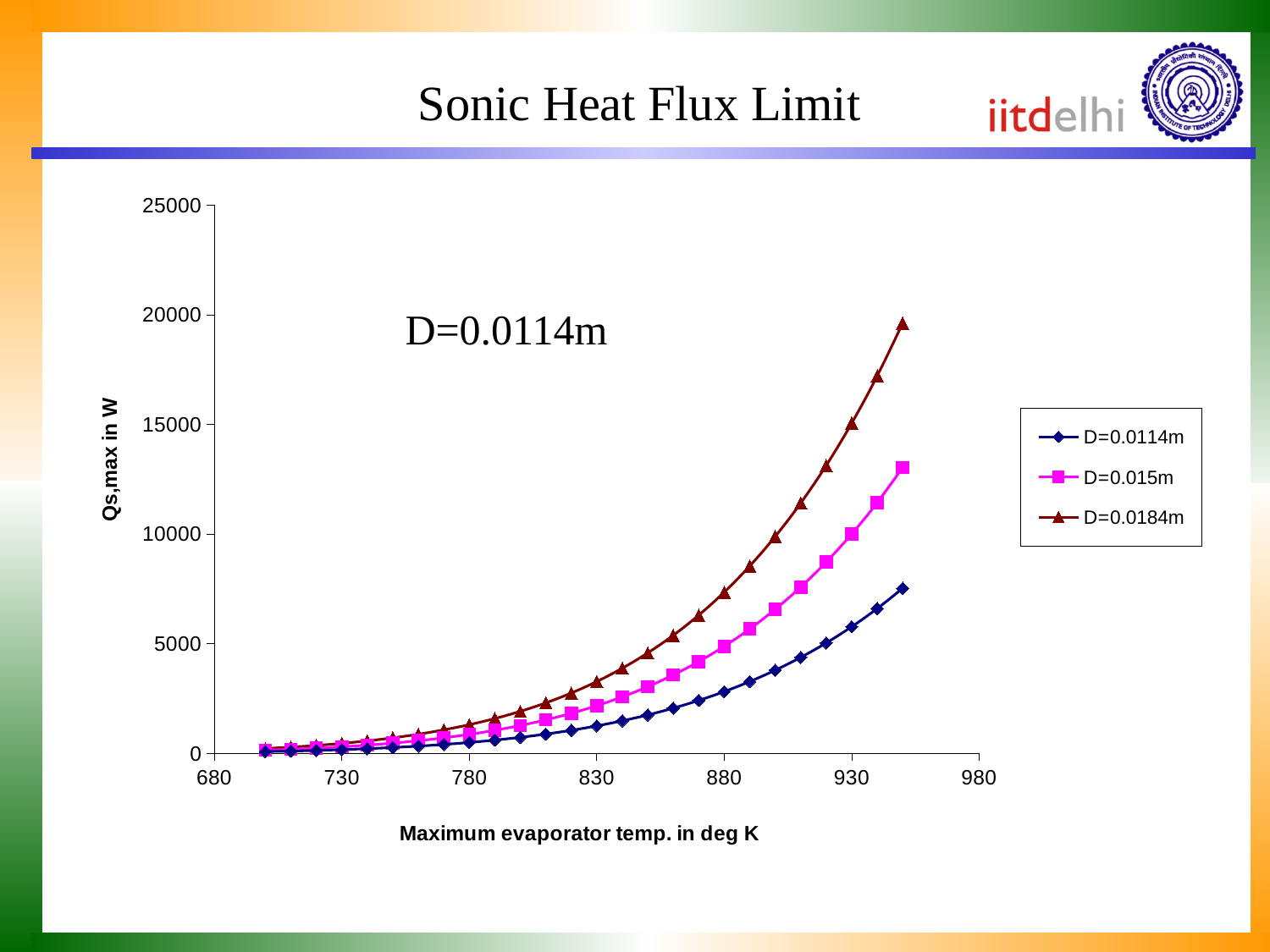
At 930 deg K, which series has the larger value, D=0.015m or D=0.0114m? D=0.015m What kind of chart is shown on the slide? line chart Is the value for D=0.0114m at 950 deg K greater or less than 10000? less What is the title of the y axis? Qs,max in W Do the values for D=0.015m rise or fall as the maximum evaporator temperature increases? rise Is the value for D=0.0114m at 950 deg K greater or less than 5000? greater Which series has the lowest values across the chart? D=0.0114m Is the value for D=0.0184m at 950 deg K greater or less than 15000? greater How many series does the legend list? 3 Which series reaches the highest value at the right end of the chart? D=0.0184m What is the title of the x axis? Maximum evaporator temp. in deg K